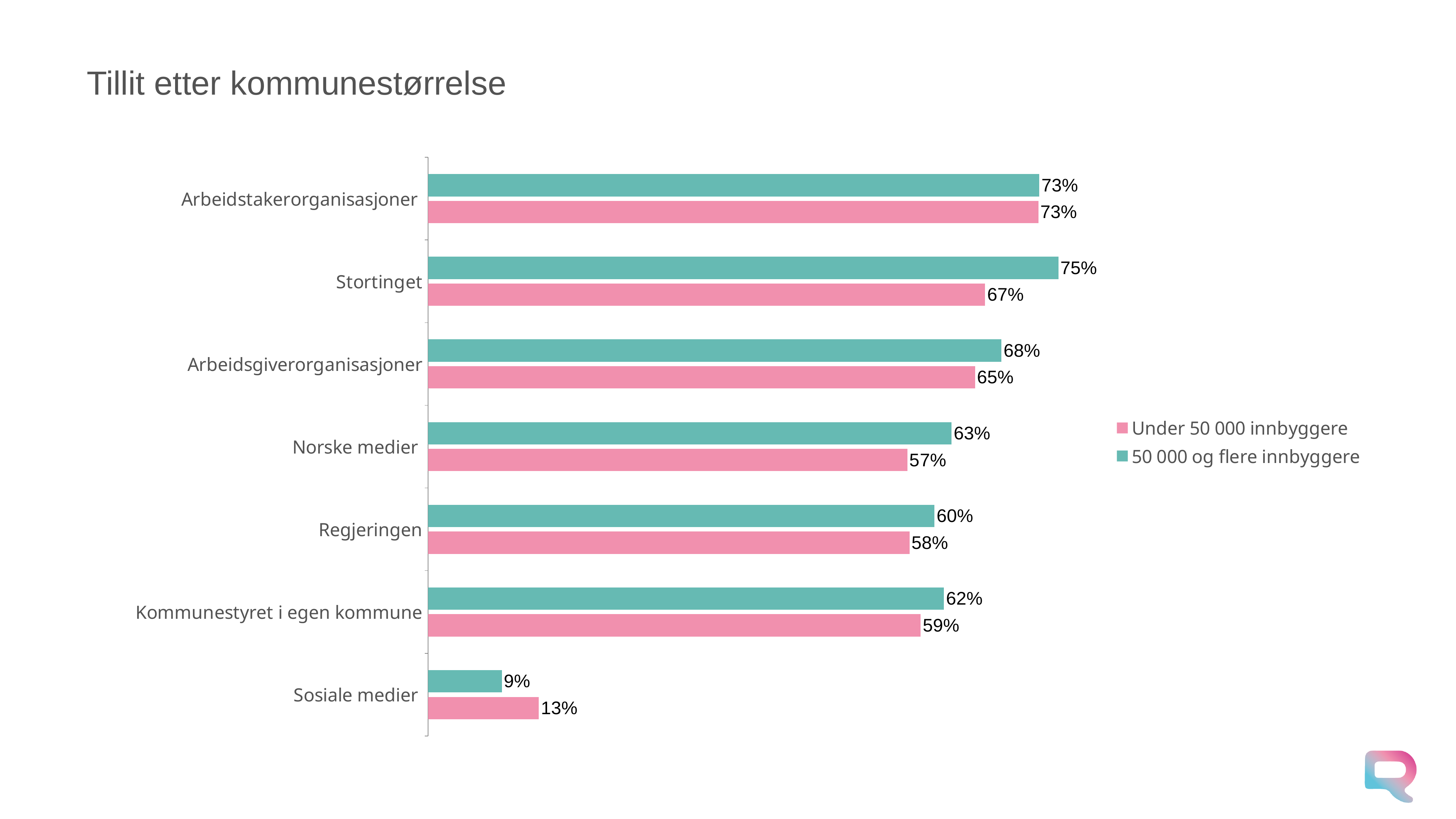
What is the title of the slide? Tillit etter kommunestørrelse What is the value for Norske medier in the 'Under 50 000 innbyggere' series? 57% What is the value for Sosiale medier in the '50 000 og flere innbyggere' series? 9% Which category has the lowest value in the 'Under 50 000 innbyggere' series? Sosiale medier Which category has the highest value in the '50 000 og flere innbyggere' series? Stortinget For Sosiale medier, which series has the larger value? Under 50 000 innbyggere What kind of chart is shown on the slide? Bar chart What is the value for Stortinget in the '50 000 og flere innbyggere' series? 75% How many series does the legend list? 2 How many categories are shown on the chart? 7 What is the difference between the two series for Norske medier? 6% What is the difference between the two series for Stortinget? 8%